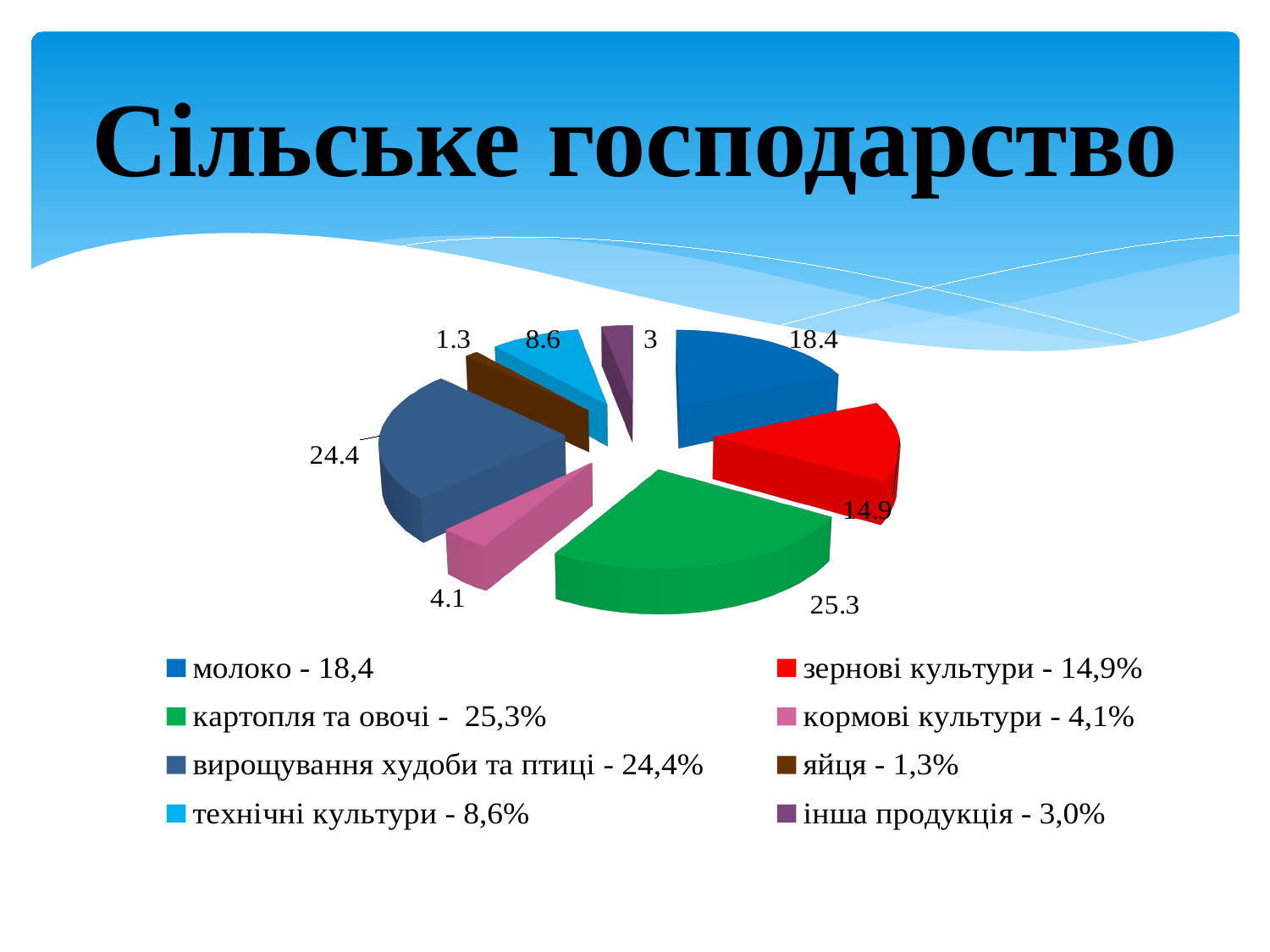
Which category has the smallest slice of the pie? яйця What is the difference between the data labels for картопля та овочі and кормові культури? 21.2 What is the data label on the slice for технічні культури? 8.6 What kind of chart is shown on the slide? pie chart What is the data label on the slice for молоко? 18.4 What is the difference between the data labels for вирощування худоби та птиці and технічні культури? 15.8 Which category has the largest slice of the pie? картопля та овочі Which is larger, the slice for молоко or the slice for зернові культури? молоко How many slices does the pie chart have? 8 What is the data label on the slice for зернові культури? 14.9 What is the title of the slide containing the pie chart? Сільське господарство What is the data label on the slice for вирощування худоби та птиці? 24.4